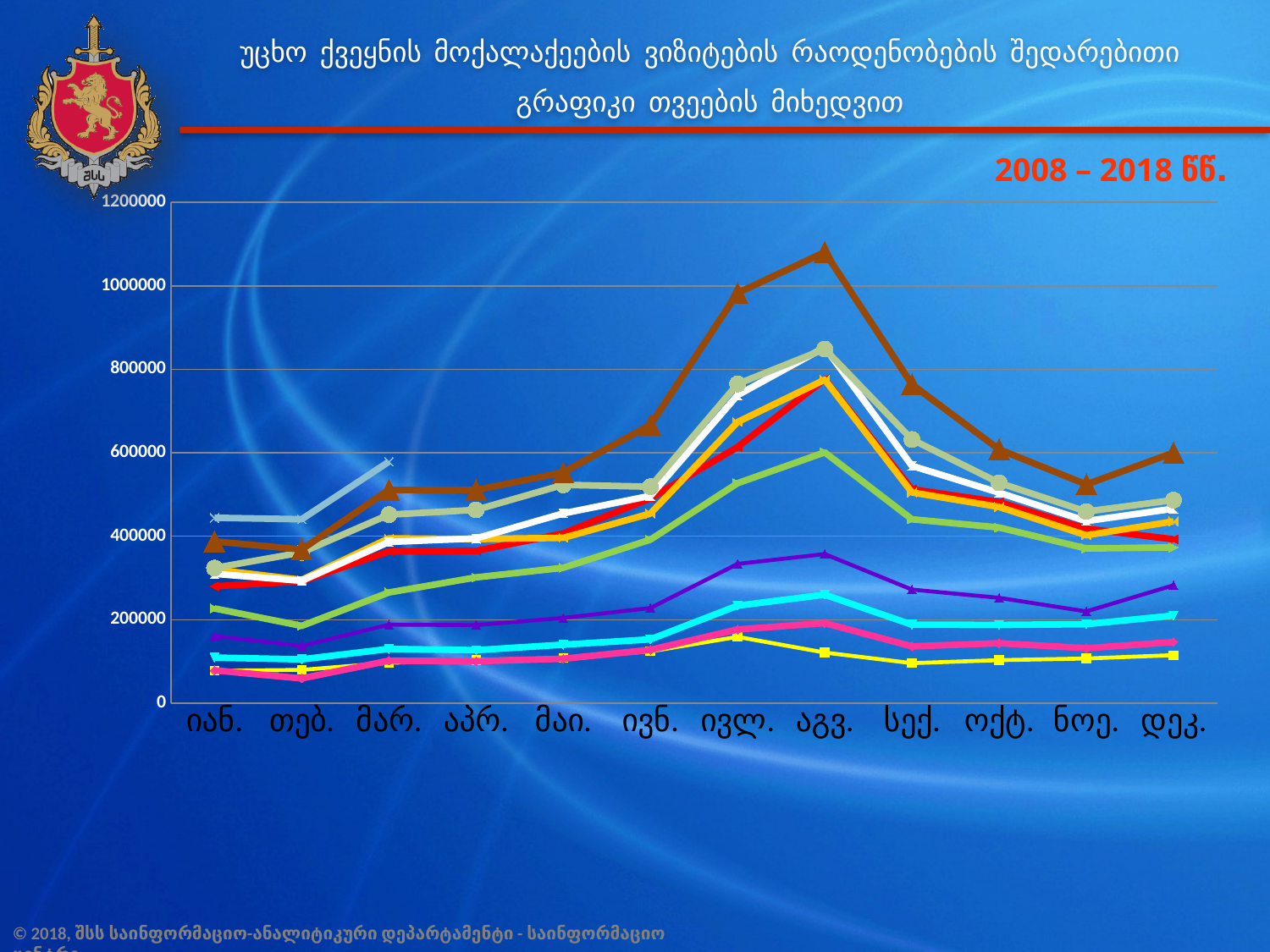
In which month does the brown line with triangle markers reach its highest point? აგვ. Which is larger in აგვ.: the brown line with triangle markers or the yellow line with square markers? the brown line with triangle markers Is the value of the brown line with triangle markers in დეკ. greater or less than 400000? greater Does the brown line with triangle markers rise or fall from აგვ. to ნოე.? fall Is the value of the yellow line with square markers in აგვ. greater or less than 200000? less How many months (categories) are shown along the x axis of the chart? 12 What kind of chart is shown on the slide? line chart What is the highest value shown on the y axis of the chart? 1200000 Is the value of the brown line with triangle markers in აგვ. greater or less than 1000000? greater What year range is printed in red above the chart? 2008 – 2018 წწ.